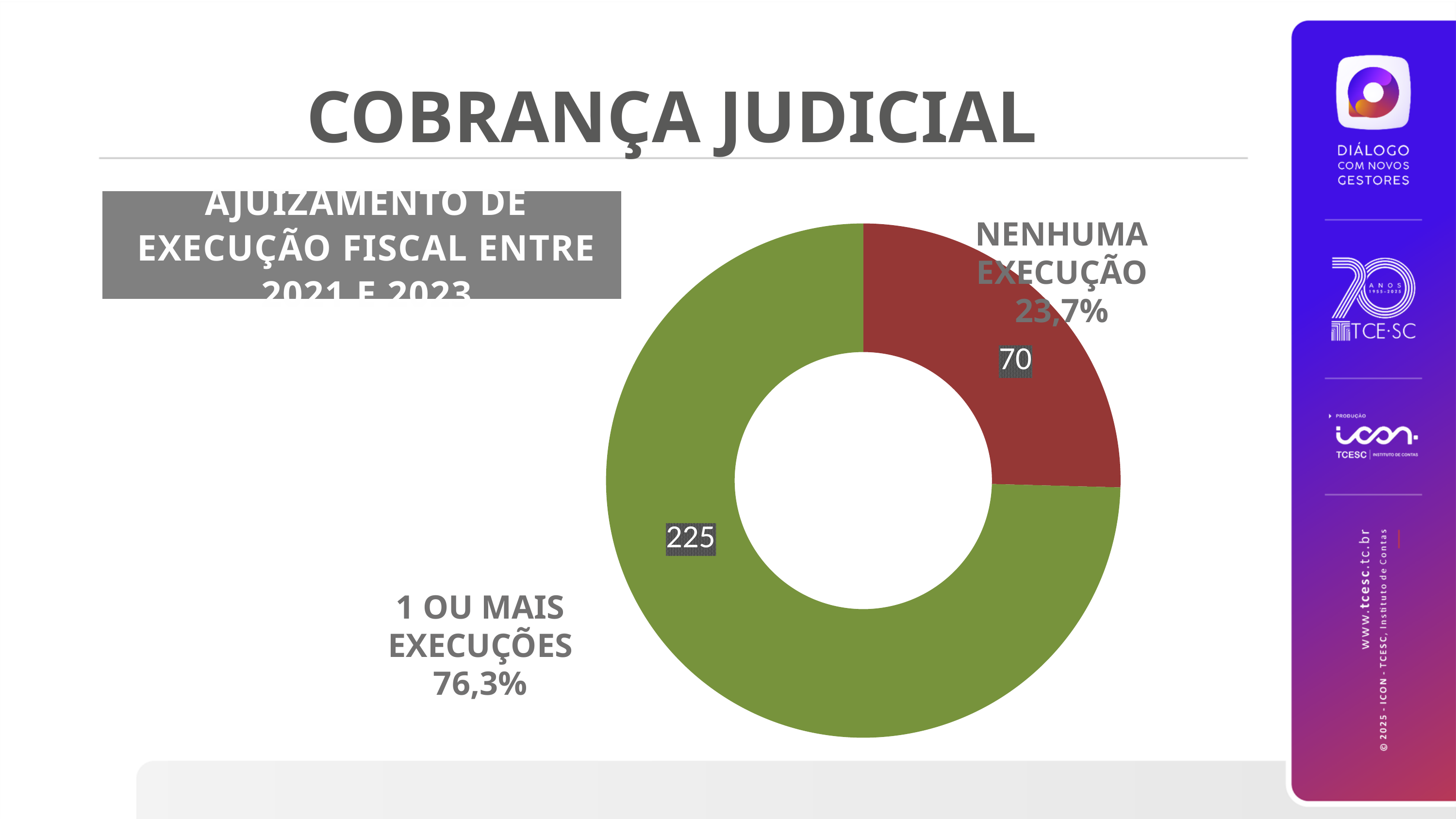
What is the value for "NENHUMA EXECUÇÃO"? 70 Which is larger, the value for "NENHUMA EXECUÇÃO" or the value for "1 OU MAIS EXECUÇÕES"? 1 OU MAIS EXECUÇÕES What share of the chart does "1 OU MAIS EXECUÇÕES" represent? 76,3% What is the difference between the values for "1 OU MAIS EXECUÇÕES" and "NENHUMA EXECUÇÃO"? 155 What kind of chart is shown on the slide? Doughnut (pie) chart How many categories does the chart show? 2 What colour is the slice for "NENHUMA EXECUÇÃO"? Red What is the value for "1 OU MAIS EXECUÇÕES"? 225 Which category has the largest value? 1 OU MAIS EXECUÇÕES What is the total of the two values shown in the chart? 295 What share of the chart does "NENHUMA EXECUÇÃO" represent? 23,7% Which category has the smallest value? NENHUMA EXECUÇÃO